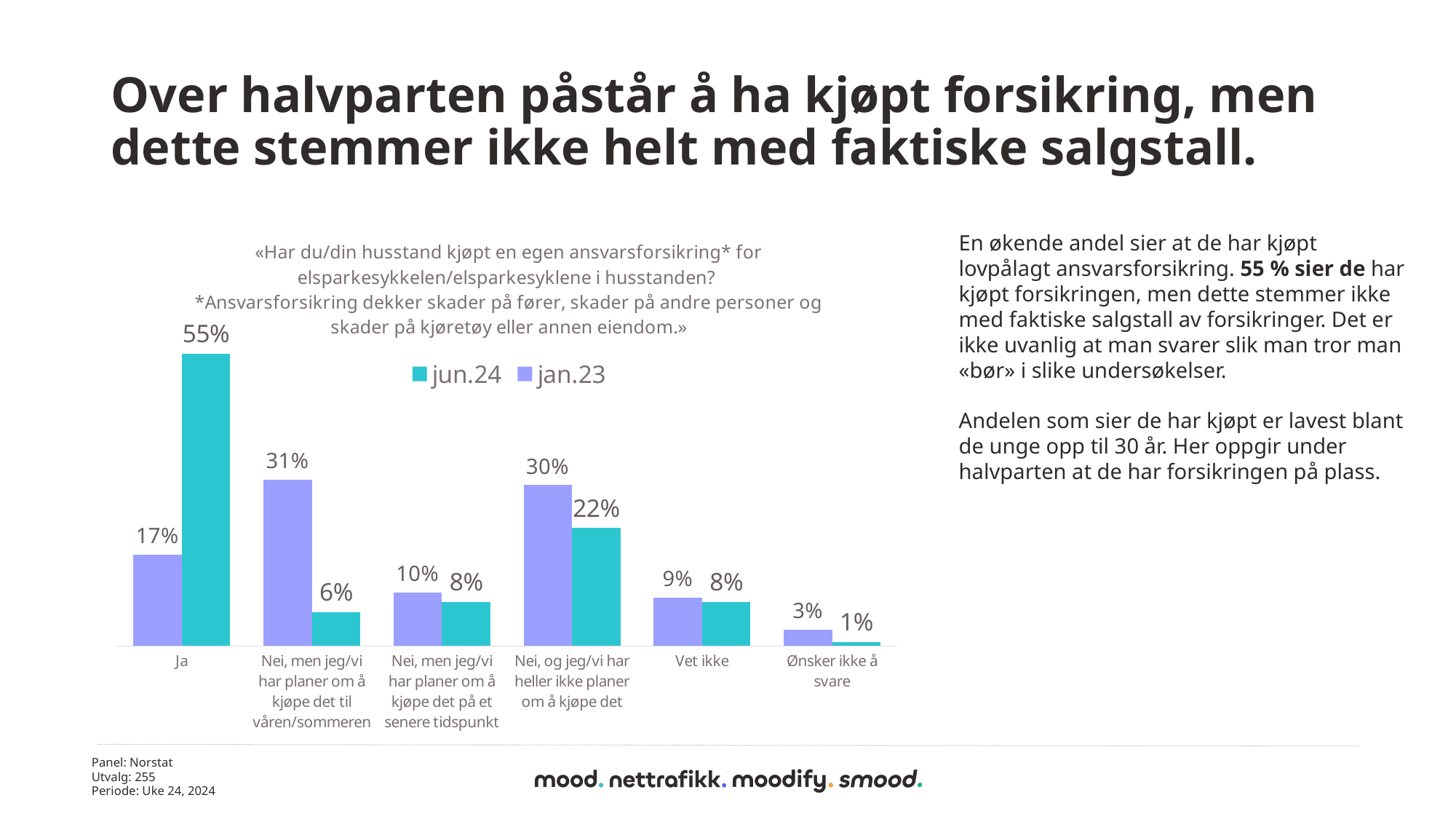
What is the jan.23 value for "Ja"? 17% What kind of chart is shown on the slide? Bar chart Which colour represents the jun.24 series in the chart? Teal What is the jun.24 value for "Ja"? 55% For "Nei, men jeg/vi har planer om å kjøpe det til våren/sommeren", which series has the larger value, jun.24 or jan.23? jan.23 What is the jun.24 value for "Nei, og jeg/vi har heller ikke planer om å kjøpe det"? 22% What is the difference between the jun.24 and jan.23 values for "Ja"? 38 percentage points How many categories are shown on the x axis? 6 Which category has the highest jun.24 value? Ja Which category has the lowest jun.24 value? Ønsker ikke å svare What is the jan.23 value for "Nei, men jeg/vi har planer om å kjøpe det til våren/sommeren"? 31% How many series does the legend list? 2